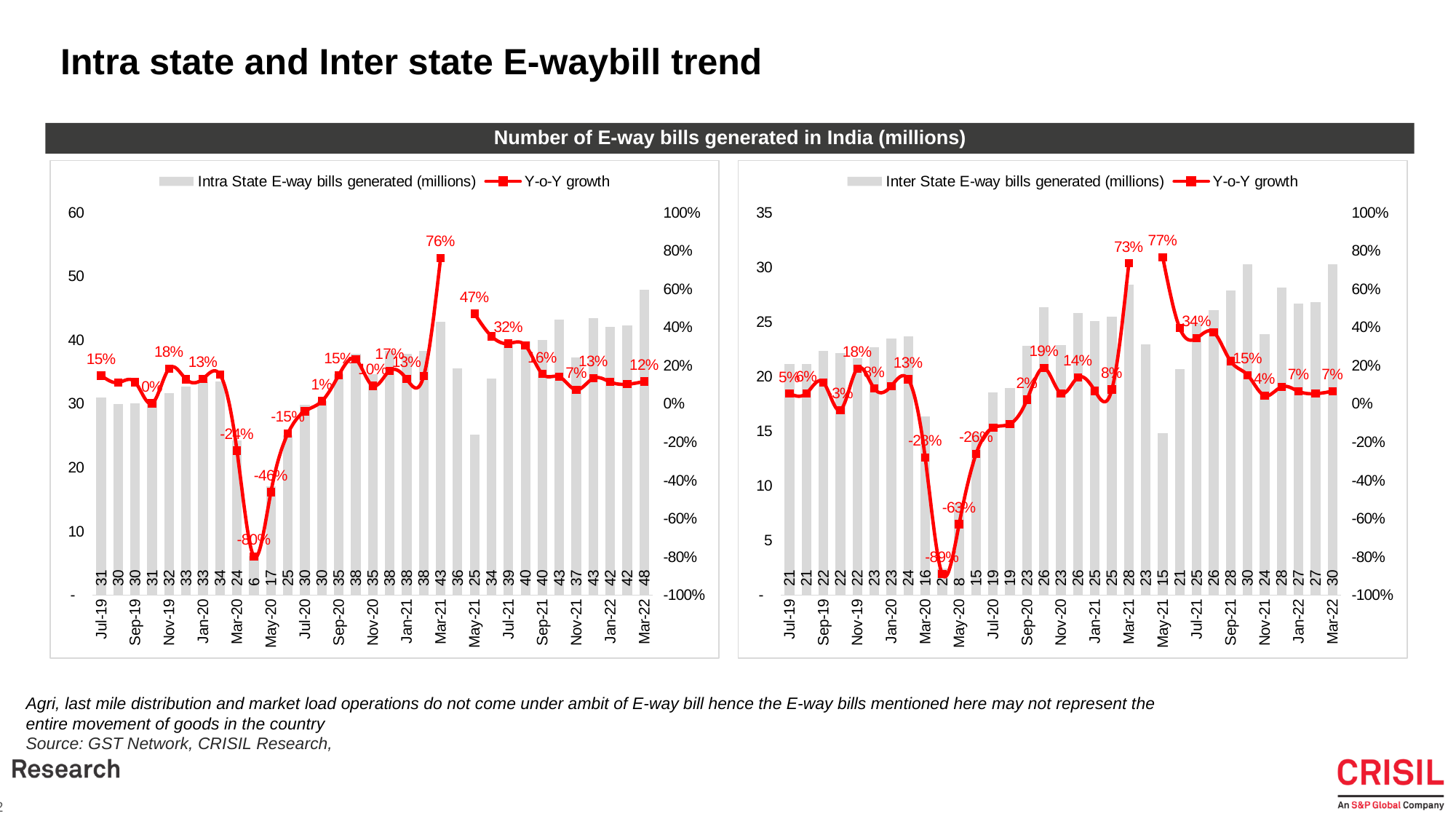
In the Intra State chart, what is the Y-o-Y growth labelled for Mar-22? 12% In the Intra State chart, what is the lowest bar value shown? 6 In the Intra State chart, what is the highest Y-o-Y growth value labelled? 76% What kind of chart is the Intra State chart? Bar chart with a line In the Intra State chart, by how much did the number of Intra State E-way bills in Mar-22 exceed that in Jul-19? 17 In the Inter State chart, what is the lowest Y-o-Y growth value labelled? -89% In the Inter State chart, how many Inter State E-way bills (millions) were generated in Mar-22? 30 In the Intra State chart, how many Intra State E-way bills (millions) were generated in Mar-22? 48 How many series does the legend of the Inter State chart list? 2 In the Inter State chart, what is the highest Y-o-Y growth value labelled? 77% In the Inter State chart, what is the Y-o-Y growth labelled for Mar-22? 7% Which was larger in Mar-22: the Intra State E-way bills or the Inter State E-way bills? Intra State E-way bills